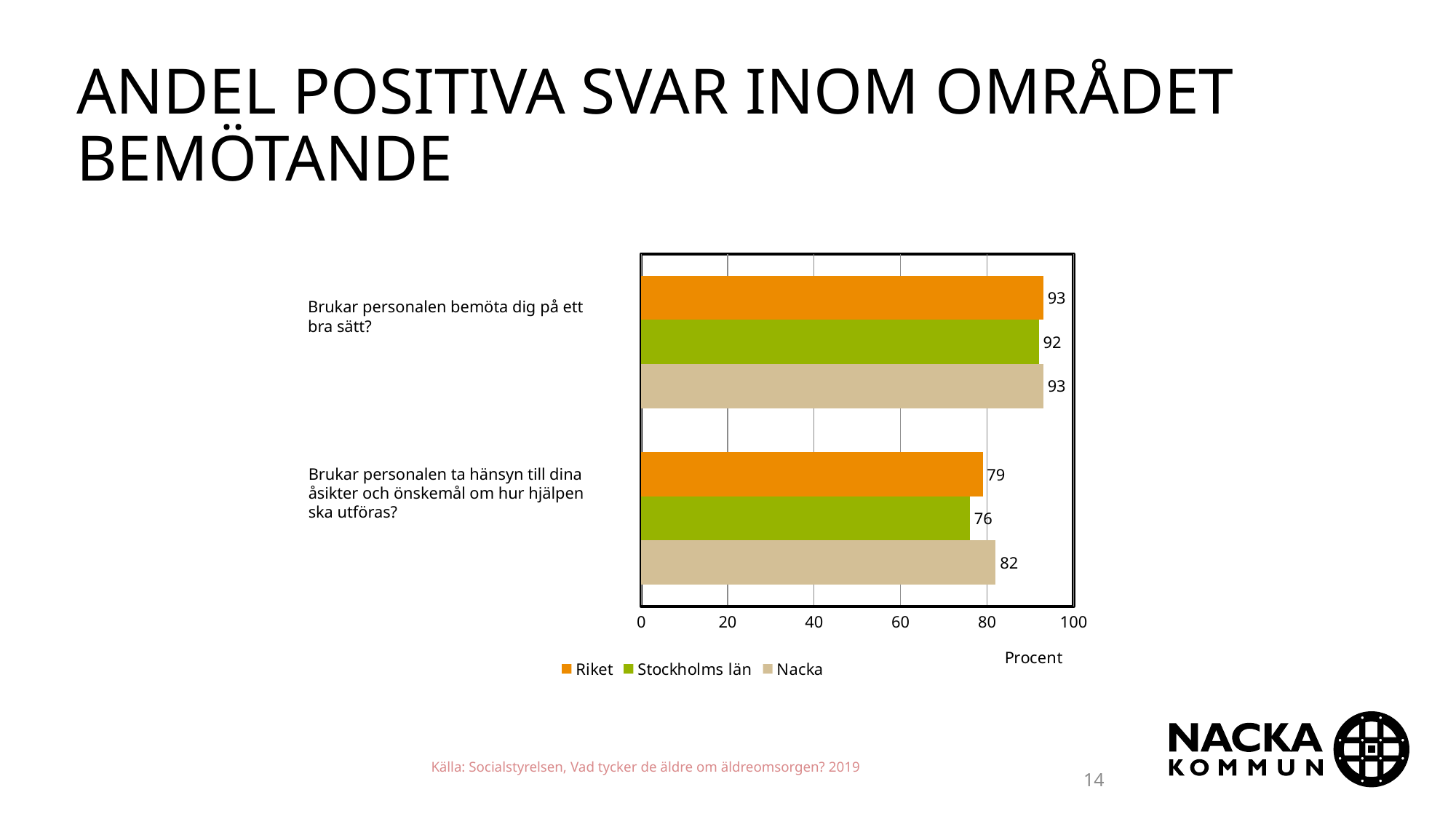
Which series has the highest value on "Brukar personalen ta hänsyn till dina åsikter och önskemål om hur hjälpen ska utföras?" Nacka Which is larger on "Brukar personalen ta hänsyn till dina åsikter och önskemål om hur hjälpen ska utföras?": Riket or Nacka? Nacka What is the value for Stockholms län on "Brukar personalen ta hänsyn till dina åsikter och önskemål om hur hjälpen ska utföras?" 76 Which series has the lowest value on "Brukar personalen ta hänsyn till dina åsikter och önskemål om hur hjälpen ska utföras?" Stockholms län What is the value for Riket on "Brukar personalen bemöta dig på ett bra sätt?" 93 Is the value for Riket on "Brukar personalen ta hänsyn till dina åsikter och önskemål om hur hjälpen ska utföras?" greater or less than 80? less What is the difference between the Nacka and Stockholms län values on "Brukar personalen ta hänsyn till dina åsikter och önskemål om hur hjälpen ska utföras?" 6 What is the value for Nacka on "Brukar personalen ta hänsyn till dina åsikter och önskemål om hur hjälpen ska utföras?" 82 What kind of chart is shown on the slide? Bar chart What is the label on the horizontal axis of the chart? Procent How many series does the legend list? 3 What is the value for Stockholms län on "Brukar personalen bemöta dig på ett bra sätt?" 92